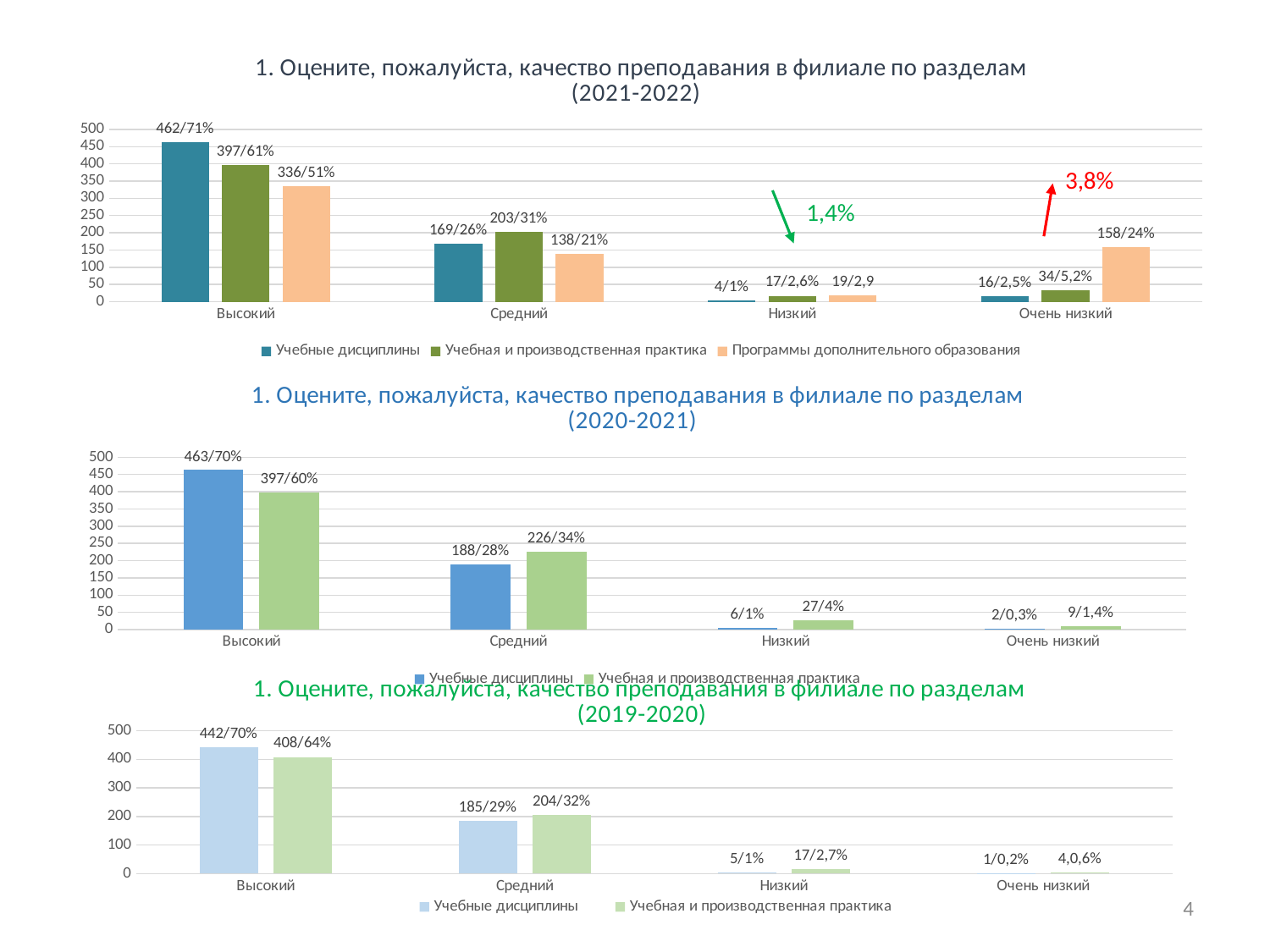
In the 2019-2020 chart (bottom), which is larger in the Средний category: Учебные дисциплины or Учебная и производственная практика? Учебная и производственная практика In the 2021-2022 chart (top), what is the data label for Учебные дисциплины in the Высокий category? 462/71% In the 2020-2021 chart (middle), which category has the lowest value for Учебные дисциплины? Очень низкий What kind of chart is the 2019-2020 chart (bottom)? Bar chart In the 2021-2022 chart (top), how many series does the legend list? 3 In the 2019-2020 chart (bottom), what is the difference in count between Учебные дисциплины (442) and Учебная и производственная практика (408) in the Высокий category? 34 In the 2020-2021 chart (middle), what is the data label for Учебная и производственная практика in the Средний category? 226/34% In the 2021-2022 chart (top), what is the data label for Программы дополнительного образования in the Очень низкий category? 158/24% In the 2020-2021 chart (middle), how many categories are shown on the x axis? 4 In the 2019-2020 chart (bottom), what is the data label for Учебные дисциплины in the Высокий category? 442/70% In the 2021-2022 chart (top), which series has the highest value in the Средний category? Учебная и производственная практика